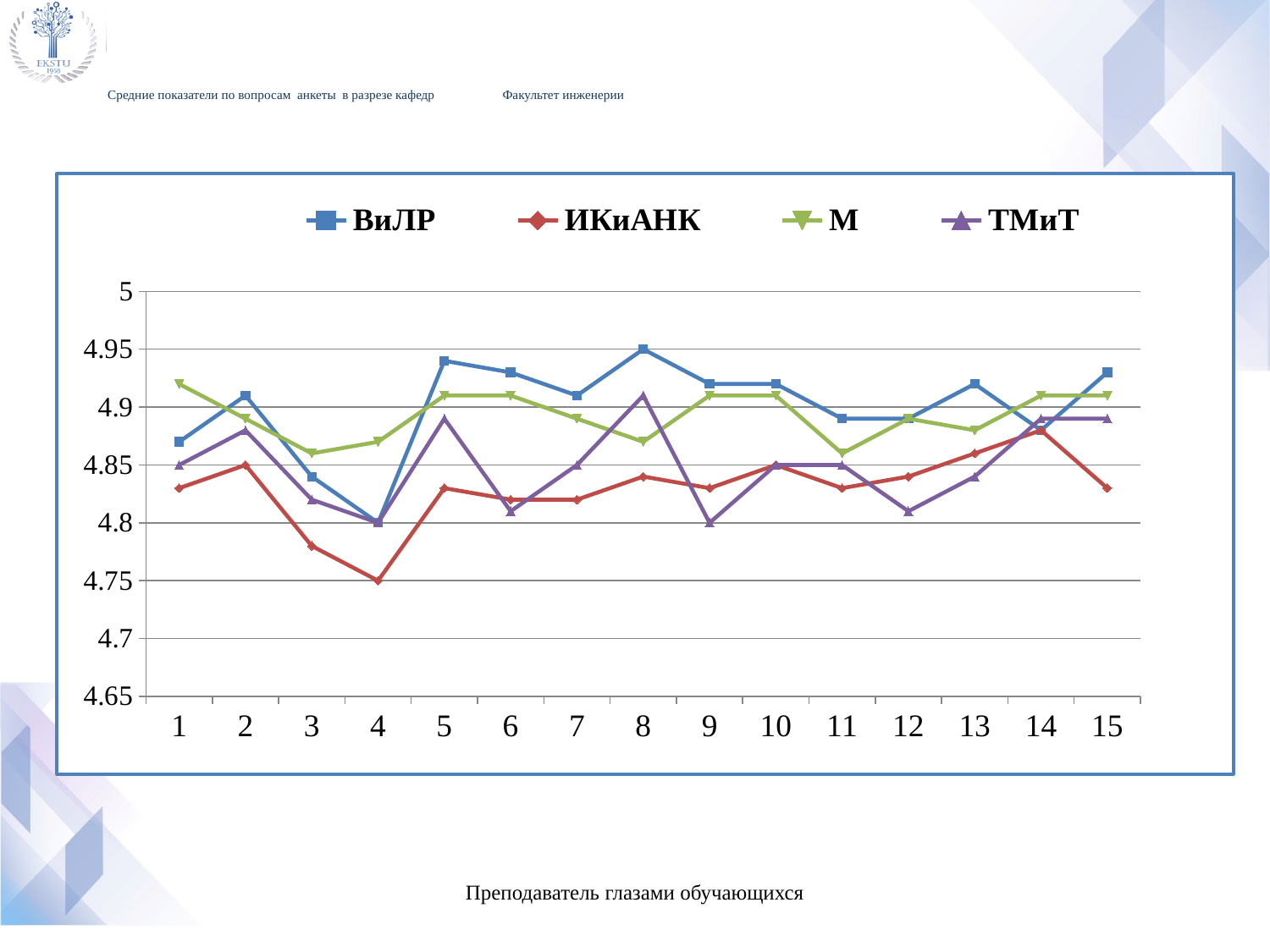
Which series has the highest value at point 1? М What kind of chart is shown on the slide? line chart Which series has the lowest value at point 4? ИКиАНК What is the value of the ИКиАНК series at point 4? 4.75 What is the value of the ВиЛР series at point 8? 4.95 Is the value of the ИКиАНК series at point 3 greater or less than 4.8? less Is the value of the ТМиТ series at point 6 greater or less than 4.85? less At which x-axis point does the ВиЛР series reach its highest value? 8 How many series does the legend list? 4 At which x-axis point does the ИКиАНК series reach its lowest value? 4 How many points are there along the x axis? 15 Is the value of the ВиЛР series at point 5 greater or less than 4.9? greater